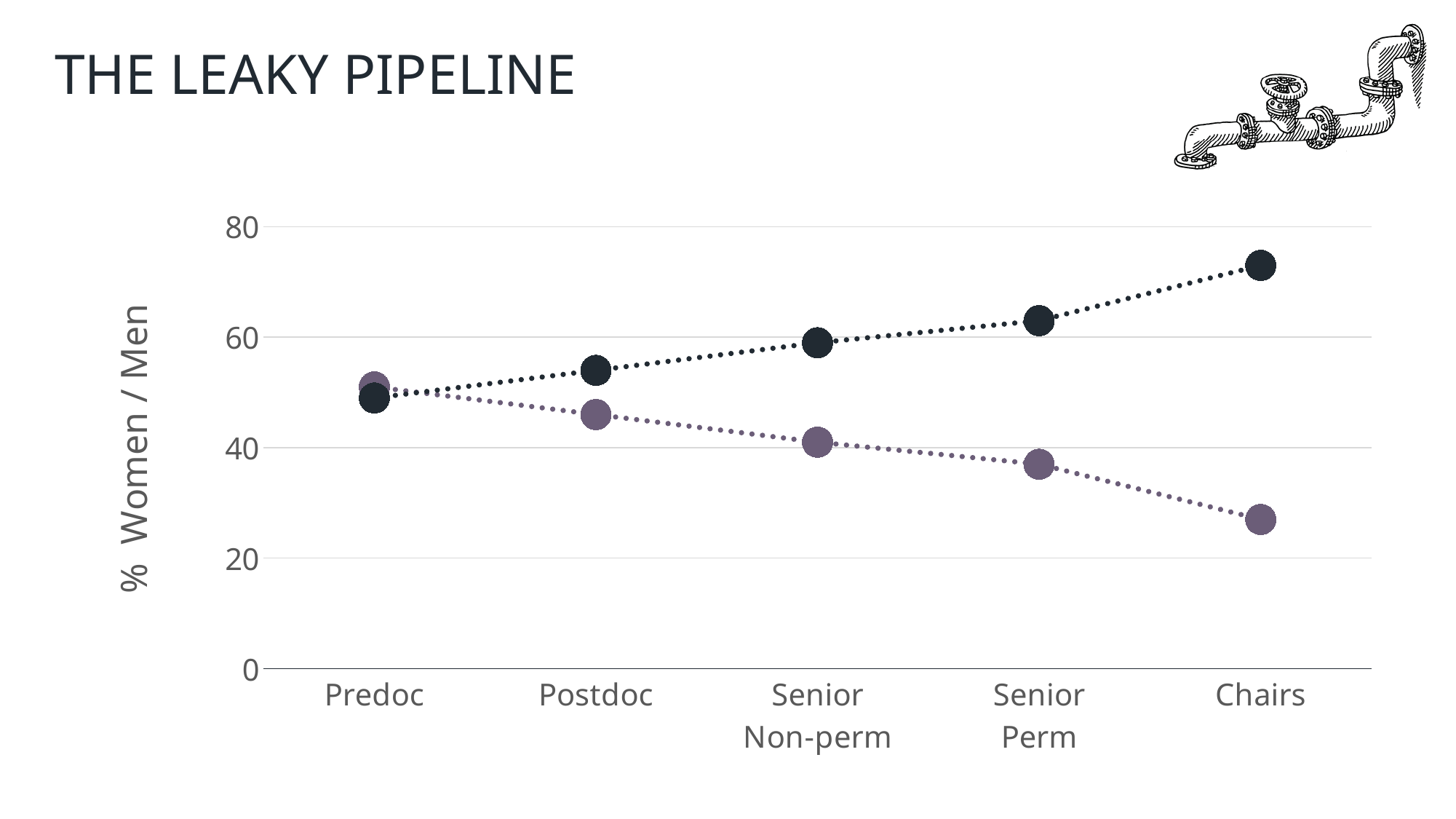
What kind of chart is shown on the slide? line chart How many career-stage categories are shown on the x axis? 5 What is the label on the y axis of the chart? % Women / Men Is the value of the dark series at Senior Non-perm greater or less than 40? greater Is the value of the purple series at Postdoc greater or less than 60? less Is the value of the dark series at Chairs greater or less than 60? greater At Chairs, which series has the larger value, the dark series or the purple series? the dark series Does the purple series rise or fall from Predoc to Chairs? fall At which category does the dark series reach its highest value? Chairs Does the dark series rise or fall from Predoc to Chairs? rise At which category does the purple series reach its lowest value? Chairs